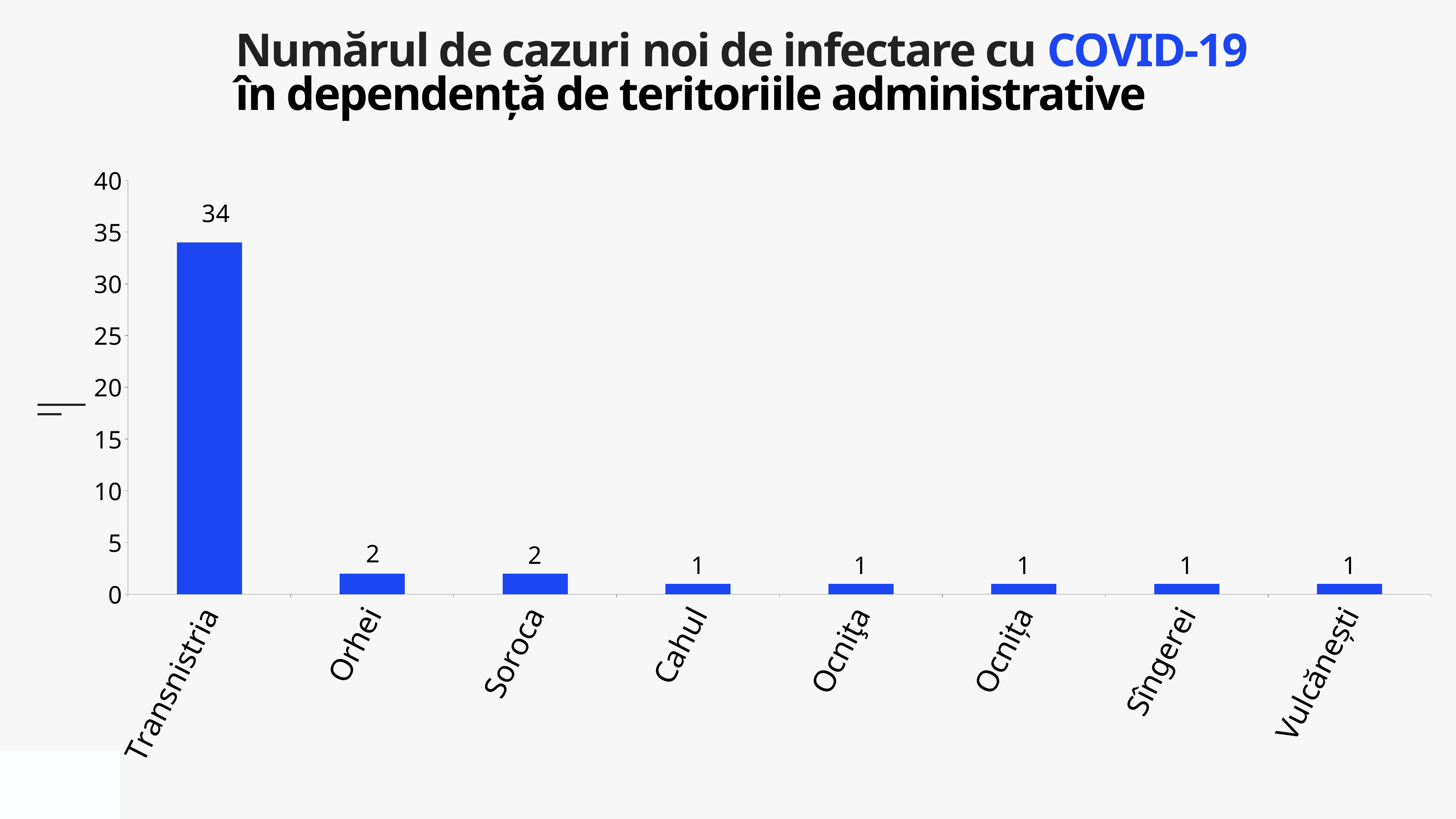
Do the values generally rise or fall from left to right along the x axis? fall What is the value for Soroca? 2 What kind of chart is shown on the slide? bar chart What is the value for Orhei? 2 Which is larger, the value for Transnistria or the value for Soroca? Transnistria What is the value for Vulcănești? 1 Is the value for Transnistria greater or less than 30? greater What is the value for Transnistria? 34 Which category has the highest value? Transnistria What is the difference between the values for Transnistria and Orhei? 32 What is the value for Cahul? 1 How many categories are shown on the x axis? 8